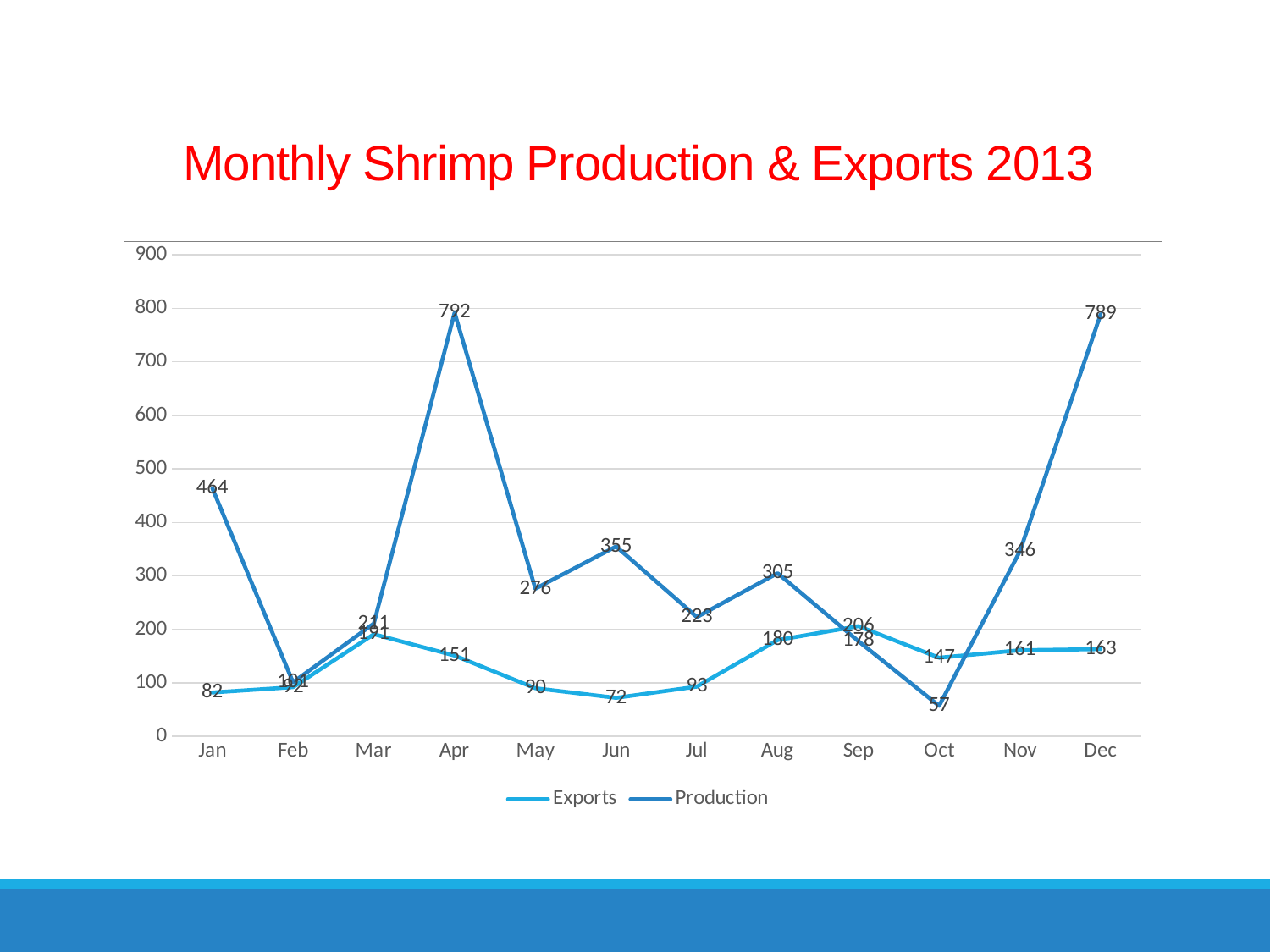
Which is larger: Production in Jan or Production in Nov? Jan In which month is Production lowest? Oct How many months are plotted along the x axis? 12 What is the Production value for Dec? 789 How many series does the legend list? 2 What is the Production value for Apr? 792 Is the Production value for Nov greater or less than 300? greater In which month are Exports lowest? Jun What is the title of the chart? Monthly Shrimp Production & Exports 2013 What is the Exports value for Oct? 147 What is the difference between Production and Exports in Jun? 283 What kind of chart is shown on the slide? line chart